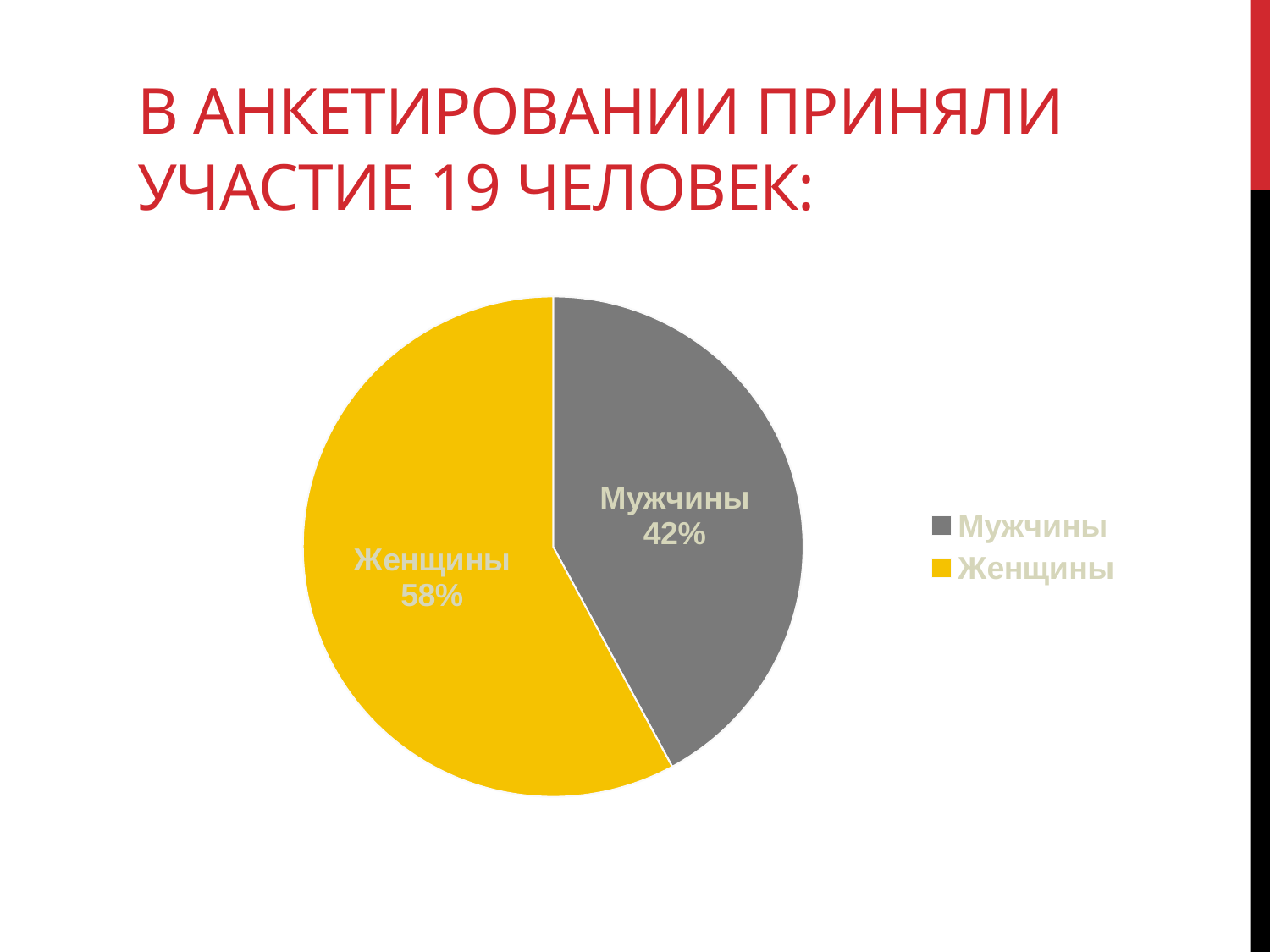
What kind of chart is shown on the slide? Pie chart Which slice is larger, Мужчины or Женщины? Женщины Which category has the smallest slice of the pie? Мужчины How many entries does the legend list? 2 What is the difference in percentage points between the Женщины and Мужчины slices? 16% Which category has the largest slice of the pie? Женщины What colour is the Женщины slice? Yellow What share of the pie does Мужчины represent? 42% How many slices does the pie chart have? 2 Is the share for Мужчины greater or less than 50%? less What colour is the Мужчины slice? Grey What share of the pie does Женщины represent? 58%